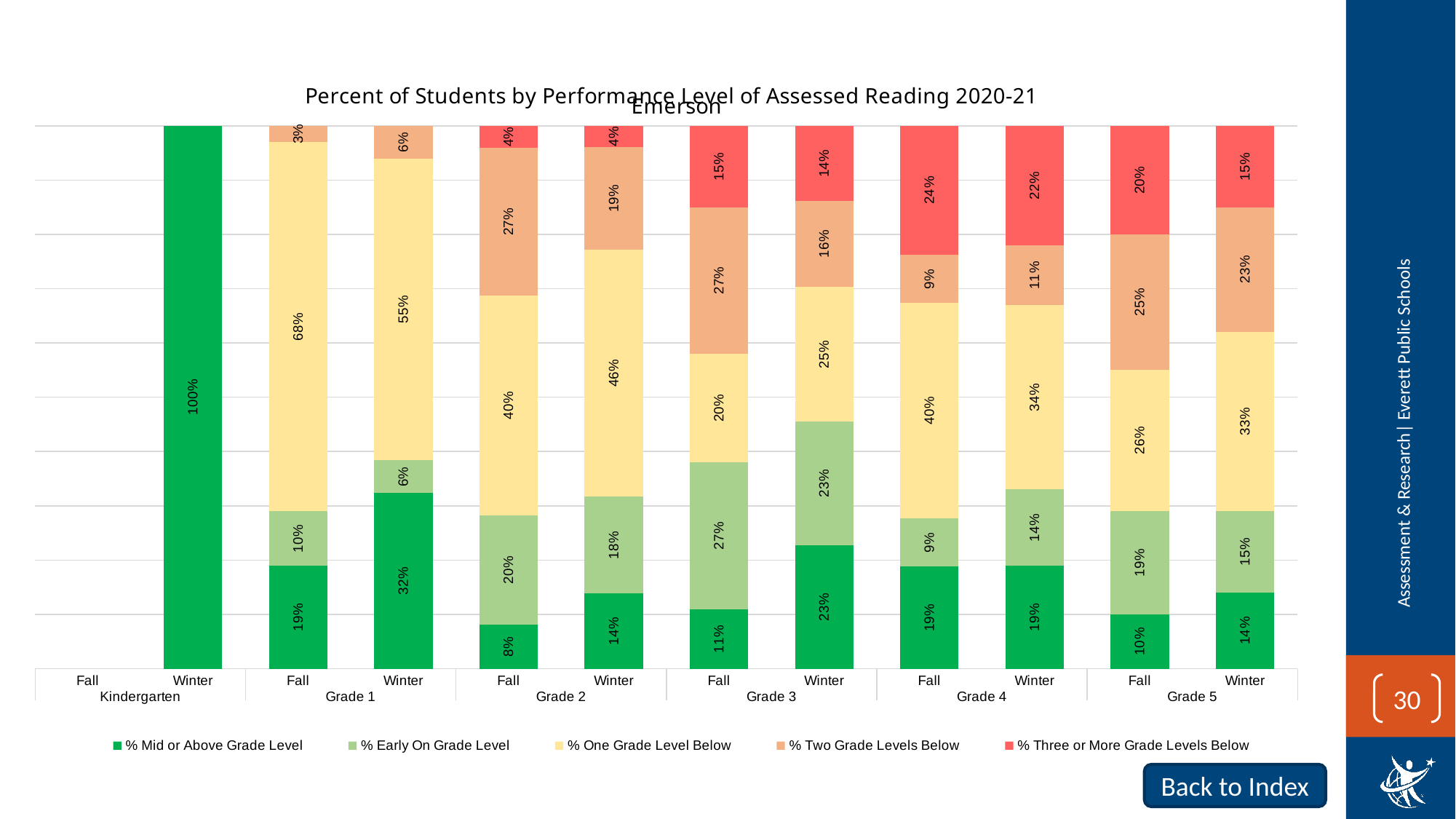
What is the % Two Grade Levels Below value for Grade 5 Winter? 23% Which bar has the highest % Mid or Above Grade Level value? Kindergarten Winter Which series is shown in red in the legend? % Three or More Grade Levels Below What is the difference between the % Mid or Above Grade Level values for Grade 1 Winter and Grade 1 Fall? 13% What is the % Early On Grade Level value for Grade 3 Fall? 27% What is the % Mid or Above Grade Level value for Grade 1 Winter? 32% What is the % One Grade Level Below value for Grade 1 Fall? 68% How many series does the legend list? 5 What kind of chart is shown on the slide? Stacked bar chart What is the % Three or More Grade Levels Below value for Grade 4 Fall? 24% Which is larger: the % One Grade Level Below value for Grade 2 Winter or for Grade 3 Winter? Grade 2 Winter Which bar has the lowest % Mid or Above Grade Level value among the bars shown? Grade 2 Fall